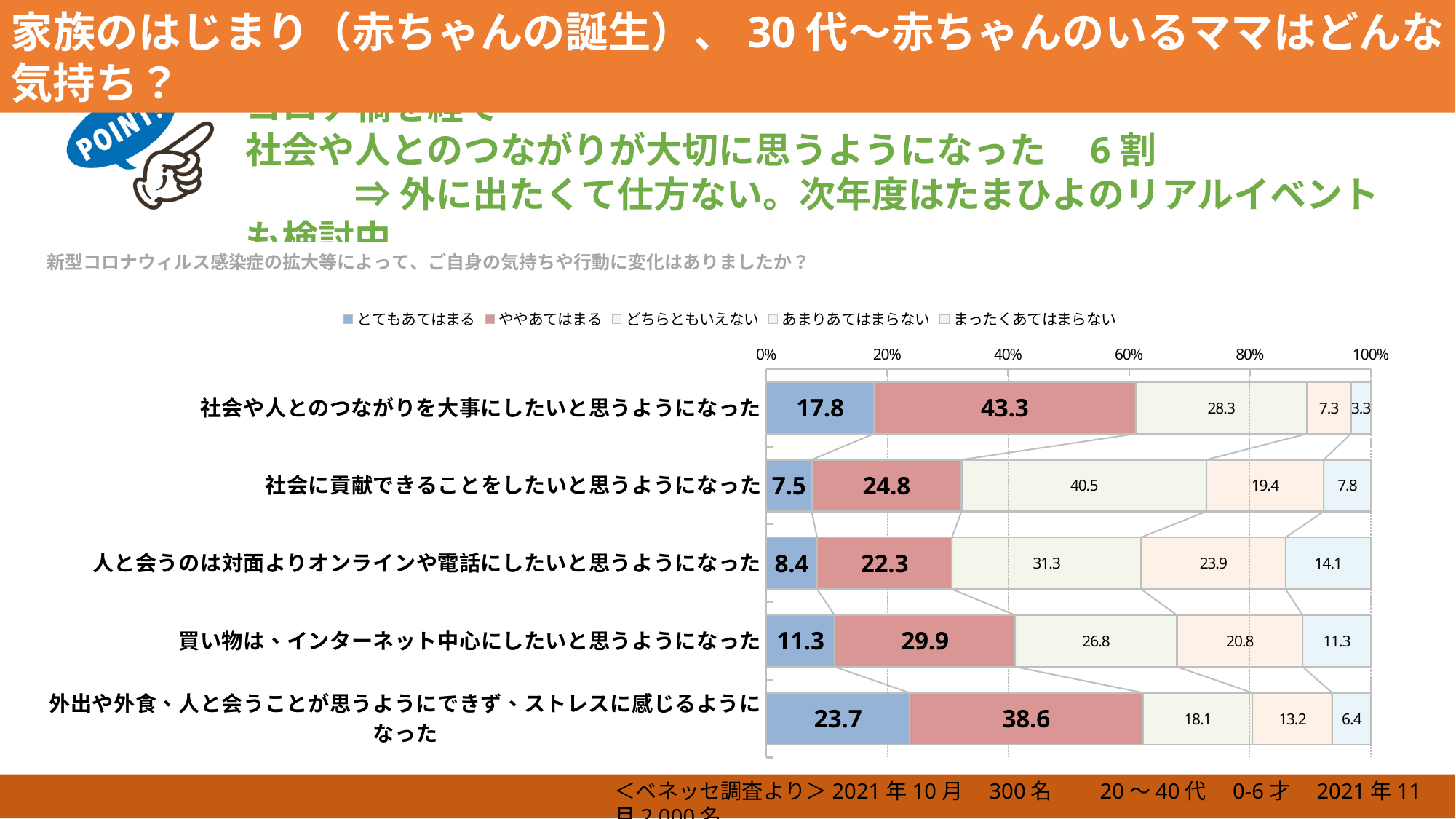
How many categories are shown in the chart? 5 What kind of chart is shown on the slide? Stacked bar chart What is the value of ややあてはまる for 買い物は、インターネット中心にしたいと思うようになった? 29.9 Which category has the highest value for とてもあてはまる? 外出や外食、人と会うことが思うようにできず、ストレスに感じるようになった What is the difference between the ややあてはまる values for 社会や人とのつながりを大事にしたいと思うようになった and 社会に貢献できることをしたいと思うようになった? 18.5 Which category has the lowest value for ややあてはまる? 人と会うのは対面よりオンラインや電話にしたいと思うようになった Which is larger: the あまりあてはまらない value for 人と会うのは対面よりオンラインや電話にしたいと思うようになった or for 買い物は、インターネット中心にしたいと思うようになった? 人と会うのは対面よりオンラインや電話にしたいと思うようになった What is the value of とてもあてはまる for 社会や人とのつながりを大事にしたいと思うようになった? 17.8 What is the combined value of とてもあてはまる and ややあてはまる for 外出や外食、人と会うことが思うようにできず、ストレスに感じるようになった? 62.3 How many series does the legend list? 5 What is the value of どちらともいえない for 社会に貢献できることをしたいと思うようになった? 40.5 What is the value of まったくあてはまらない for 人と会うのは対面よりオンラインや電話にしたいと思うようになった? 14.1